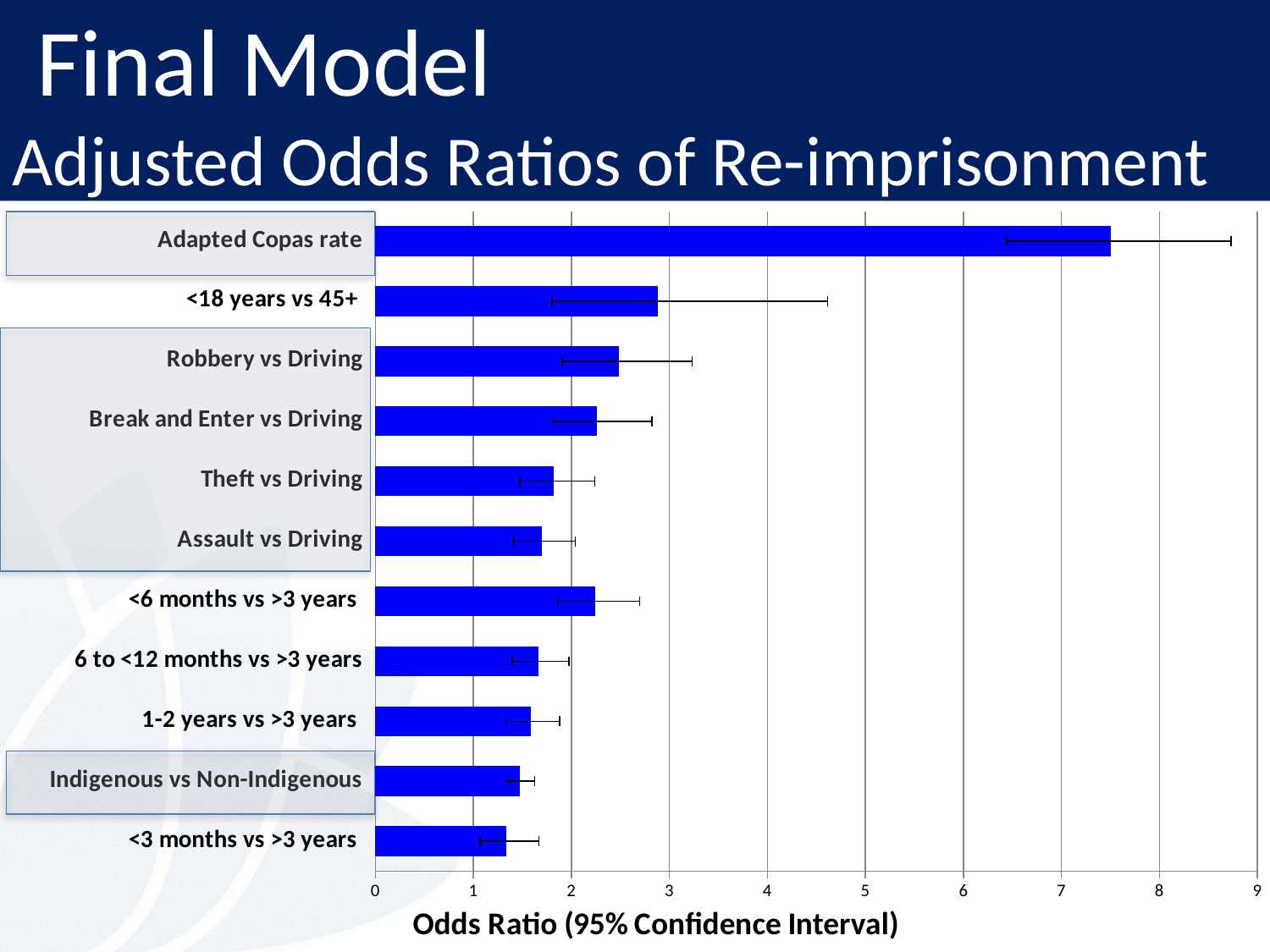
Is the odds ratio for Indigenous vs Non-Indigenous greater or less than 2? less Which has the larger odds ratio: <6 months vs >3 years or 1-2 years vs >3 years? <6 months vs >3 years Is the odds ratio for Robbery vs Driving greater or less than 2? greater What is the title of the horizontal axis? Odds Ratio (95% Confidence Interval) Is the odds ratio for Adapted Copas rate greater or less than 7? greater How many categories are plotted on the chart? 11 Which has the larger odds ratio: Robbery vs Driving or Break and Enter vs Driving? Robbery vs Driving Which category has the lowest adjusted odds ratio? <3 months vs >3 years Which category has the highest adjusted odds ratio? Adapted Copas rate What kind of chart is shown on the slide? Bar chart What colour are the bars in the chart? Blue